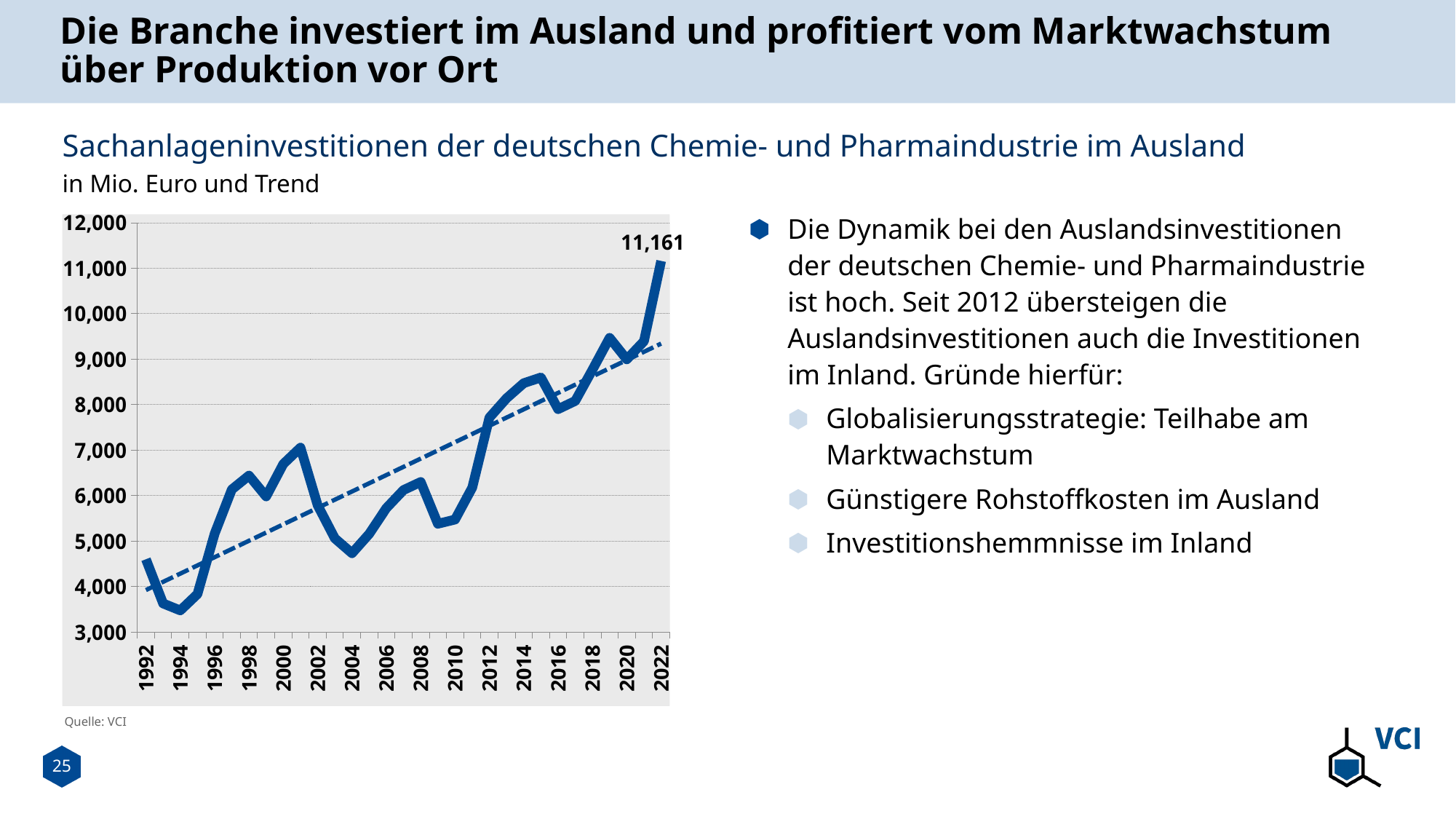
Do the values generally rise or fall from 1992 to 2022? Rise Which year has the lowest value on the chart? 1994 What is the value shown for 2022 on the chart? 11,161 What is the title of the chart? Sachanlageninvestitionen der deutschen Chemie- und Pharmaindustrie im Ausland Is the value for 1994 greater or less than 4,000? less What kind of chart is shown on the slide? Line chart Is the value for 2019 greater or less than 9,000? greater Is the value for 2004 greater or less than 5,000? less Which year has the larger value, 2004 or 2014? 2014 How many year labels are shown on the x axis? 16 Which year has the highest value on the chart? 2022